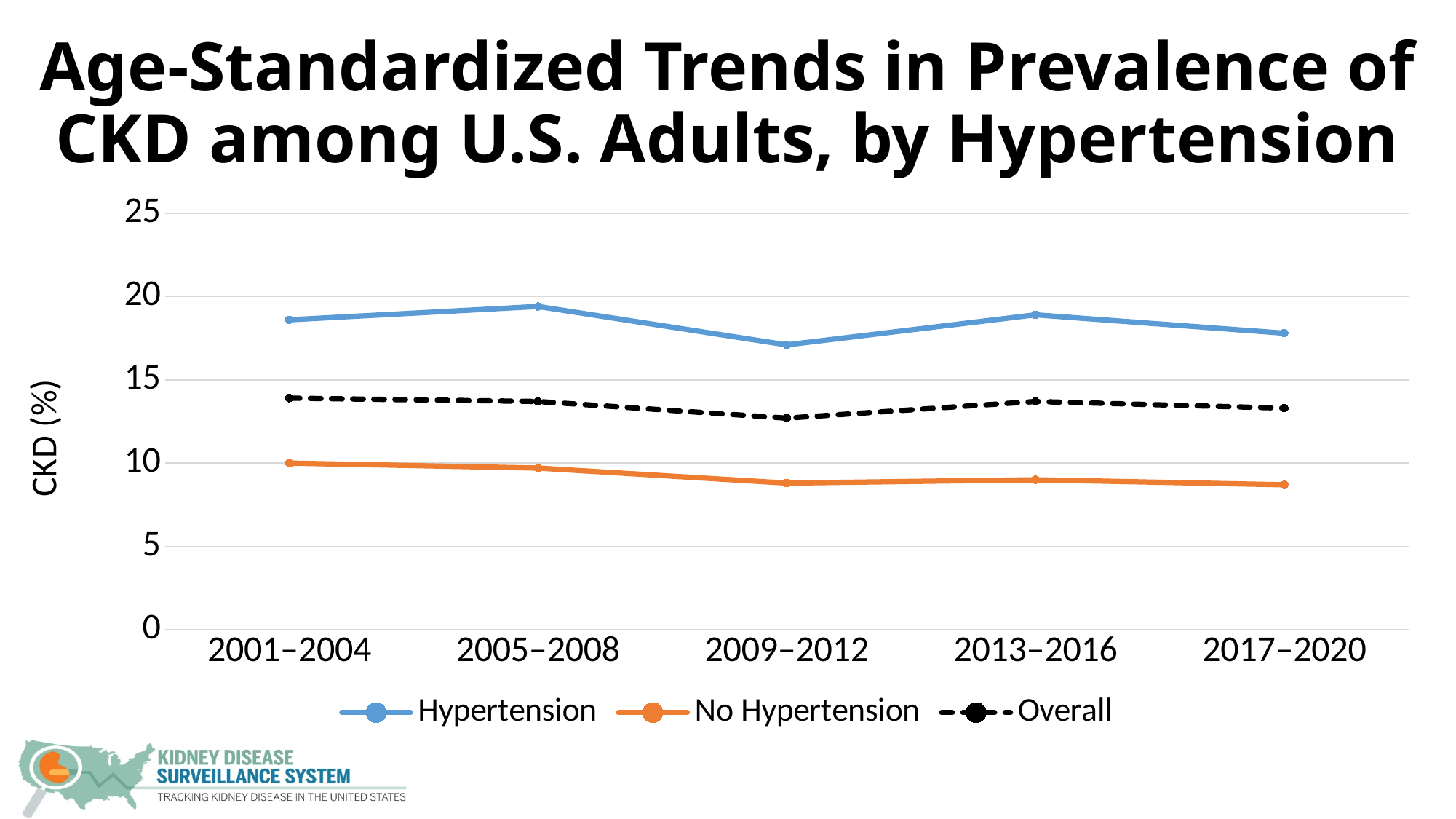
How many series does the legend list? 3 Is the value for No Hypertension in 2009–2012 greater or less than 10? less Is the value for Overall in 2001–2004 greater or less than 15? less Is the value for Hypertension in 2009–2012 greater or less than 20? less Which series is drawn with a dashed line? Overall In which period is the Hypertension series lowest? 2009–2012 In which period is the Hypertension series highest? 2005–2008 In which period is the Overall series lowest? 2009–2012 Does the No Hypertension series generally rise or fall from 2001–2004 to 2017–2020? fall In 2017–2020, which is larger: Hypertension or No Hypertension? Hypertension What kind of chart is shown on the slide? line chart How many time periods are shown on the x axis? 5